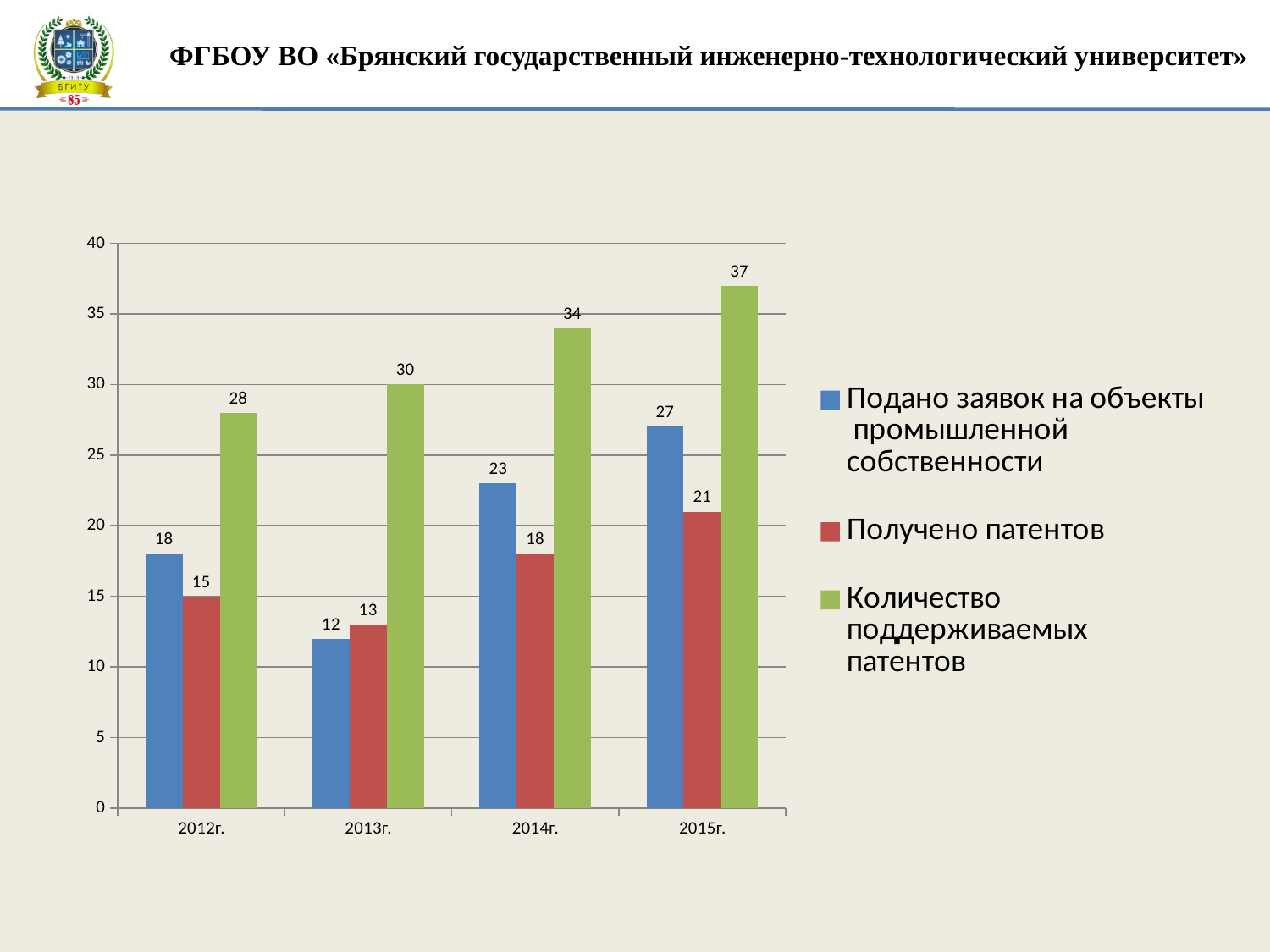
How many years are shown on the x axis? 4 Which is larger in 2013г.: "Подано заявок на объекты промышленной собственности" or "Получено патентов"? Получено патентов Does "Количество поддерживаемых патентов" rise or fall from 2012г. to 2015г.? Rise What kind of chart is shown on the slide? Bar chart In which year is "Количество поддерживаемых патентов" highest? 2015г. What value is shown for "Подано заявок на объекты промышленной собственности" in 2014г.? 23 What is the difference between "Количество поддерживаемых патентов" and "Получено патентов" in 2012г.? 13 How many series does the legend list? 3 In which year is "Подано заявок на объекты промышленной собственности" lowest? 2013г. What value is shown for "Получено патентов" in 2013г.? 13 What value is shown for "Количество поддерживаемых патентов" in 2015г.? 37 What colour represents "Получено патентов" in the legend? Red